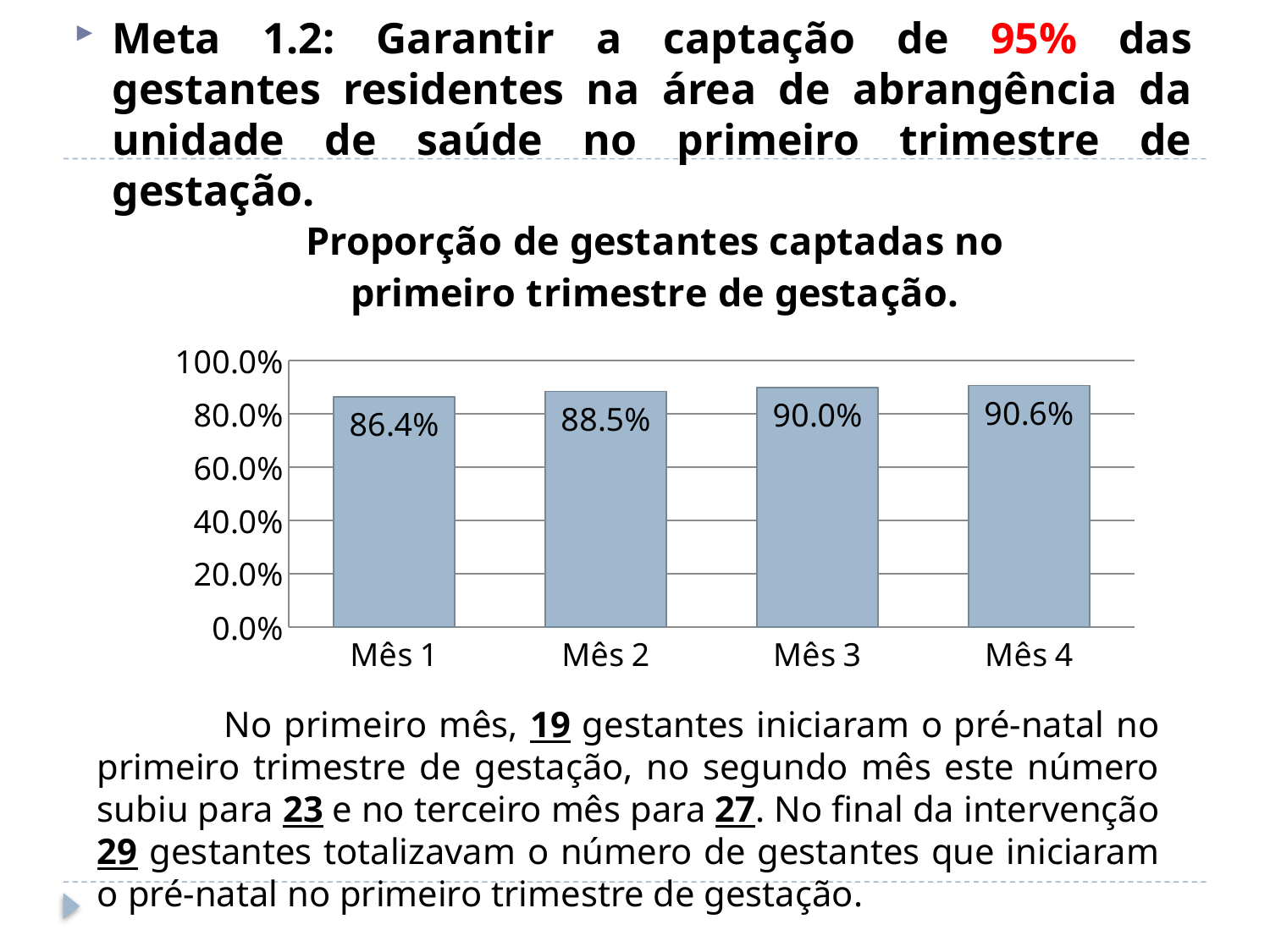
Which month has the lowest value? Mês 1 How many months are shown on the x axis? 4 What is the value for Mês 1? 86.4% What is the value for Mês 2? 88.5% What is the difference between the values for Mês 4 and Mês 1? 4.2% What is the value for Mês 3? 90.0% Is the value for Mês 1 greater or less than 80.0%? greater Which month has the highest value? Mês 4 What is the value for Mês 4? 90.6% Which is larger, the value for Mês 2 or the value for Mês 3? Mês 3 What kind of chart is shown? bar chart Do the values rise or fall from Mês 1 to Mês 4? rise